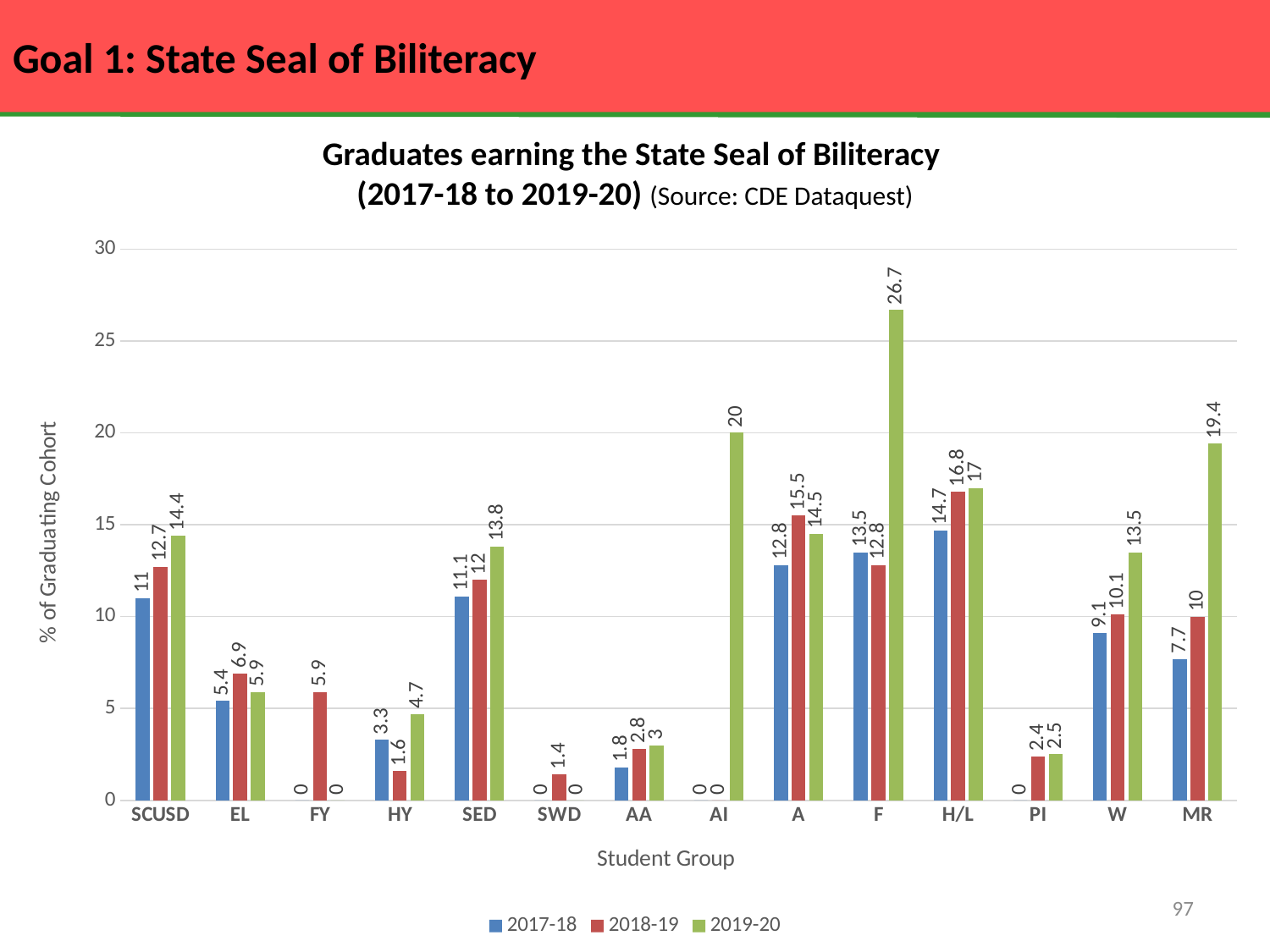
What is the 2019-20 value for F? 26.7 What is the 2017-18 value for SCUSD? 11 Which is larger for A: the 2018-19 value or the 2019-20 value? 2018-19 What is the label of the y axis? % of Graduating Cohort Do the values for SED rise or fall from 2017-18 to 2019-20? Rise What is the 2018-19 value for H/L? 16.8 How many student groups are shown on the x axis? 14 What kind of chart is shown on the slide? Bar chart What is the difference between the 2019-20 and 2017-18 values for MR? 11.7 Which student group has the lowest 2018-19 value? AI Which student group has the highest 2019-20 value? F How many series does the legend list? 3